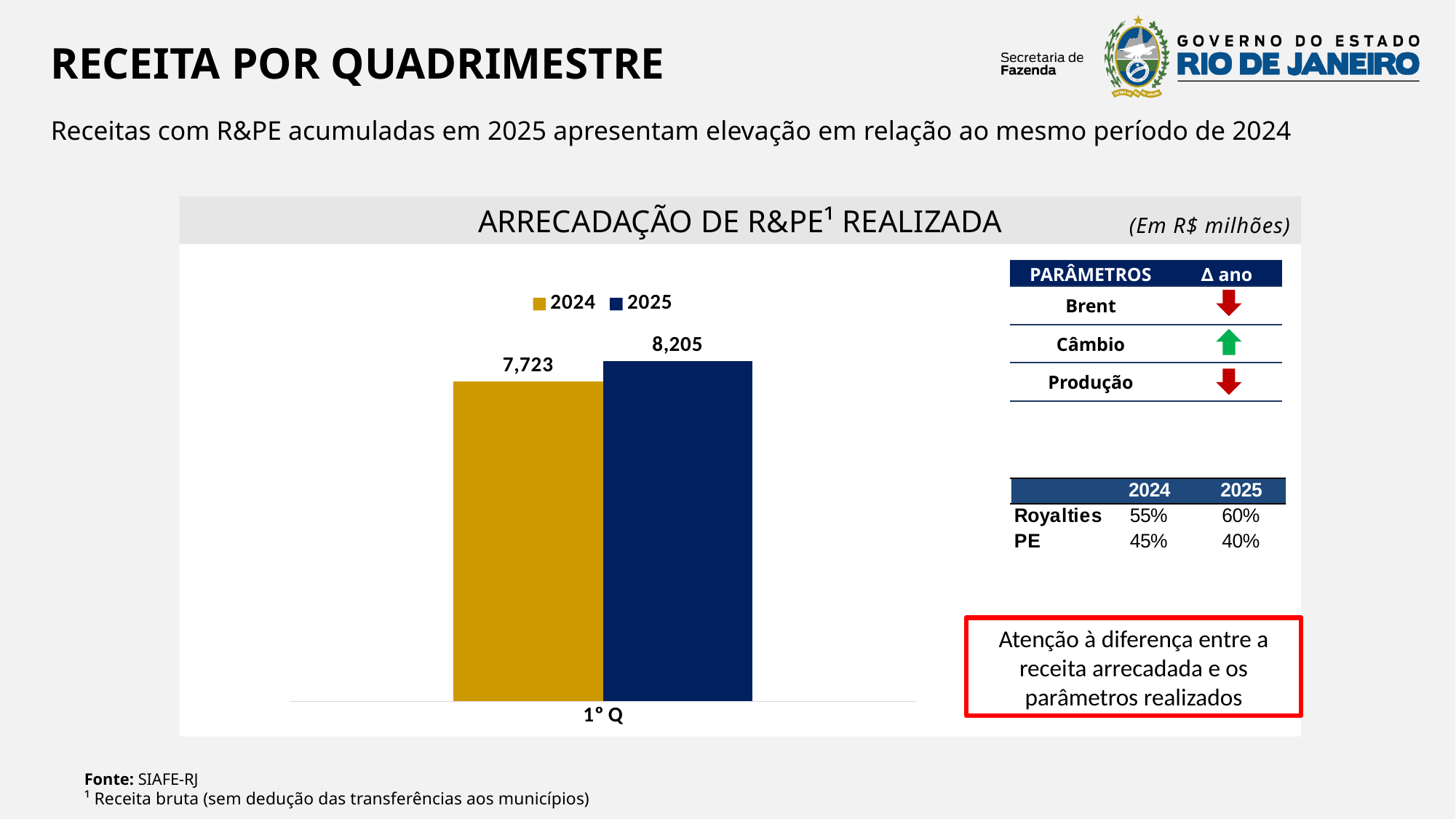
How many series does the chart legend list? 2 What is the title of the chart? ARRECADAÇÃO DE R&PE¹ REALIZADA What kind of chart is shown on the slide? Bar chart How many categories are shown on the x axis of the chart? 1 Which series has the higher value for 1° Q, 2024 or 2025? 2025 What is the value for 2024 in the 1° Q bar chart? 7,723 What is the difference between the 2025 and 2024 values for 1° Q? 482 Which series has the lowest value in the chart? 2024 What is the value for 2025 in the 1° Q bar chart? 8,205 What unit is stated for the chart values? Em R$ milhões What is the label of the category on the x axis? 1° Q